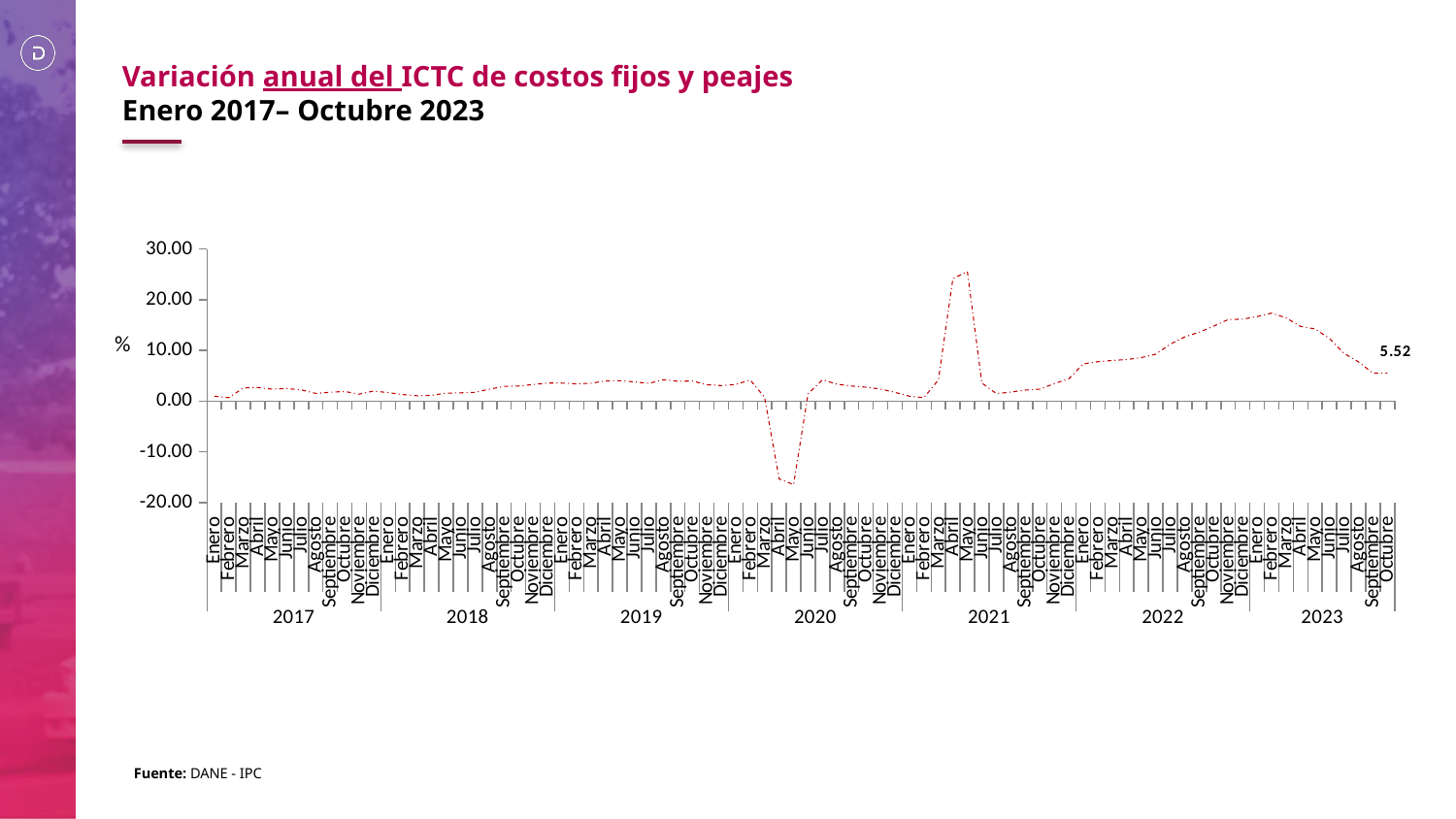
Is the value for Enero 2017 greater or less than 10.00? less Which is larger, the value for Abril 2021 or the value for Abril 2020? Abril 2021 What is the value for Octubre 2023? 5.52 Is the peak value in Abril 2021 greater or less than 20.00? greater What kind of chart is shown on the slide? Line chart In which year does the line reach its lowest point? 2020 Is the value for Abril 2020 greater or less than -10.00? less In which year does the line reach its highest point? 2021 What is the source cited below the chart? DANE - IPC How many years are labelled along the x axis? 7 Does the line rise or fall from Marzo 2023 to Octubre 2023? Fall